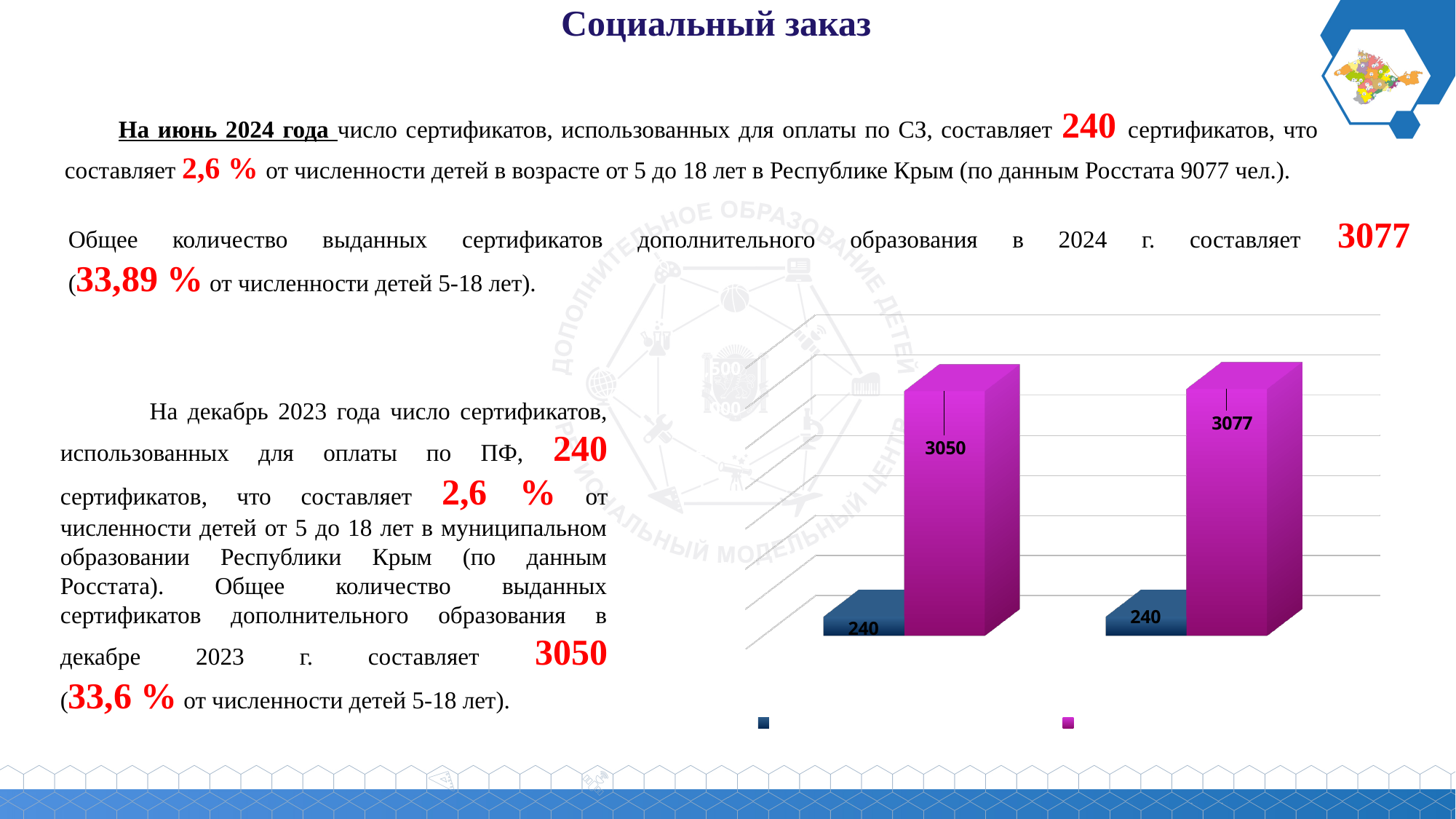
What kind of chart is shown on the slide? bar chart How many bars are plotted in the chart? 4 What is the value labelled on the dark blue bar in the right group of the chart? 240 What is the value labelled on the magenta bar in the right group of the chart? 3077 How many series does the chart's legend show? 2 Which bar has the highest value in the chart? the magenta bar in the right group (3077) What is the value labelled on the magenta bar in the left group of the chart? 3050 What is the value labelled on the dark blue bar in the left group of the chart? 240 What is the difference between the magenta bar and the dark blue bar in the left group? 2810 Do the magenta bar values rise or fall from the left group to the right group? rise What is the difference between the two magenta bars (3077 and 3050)? 27 In the right group, which bar is larger, the magenta one or the dark blue one? the magenta one